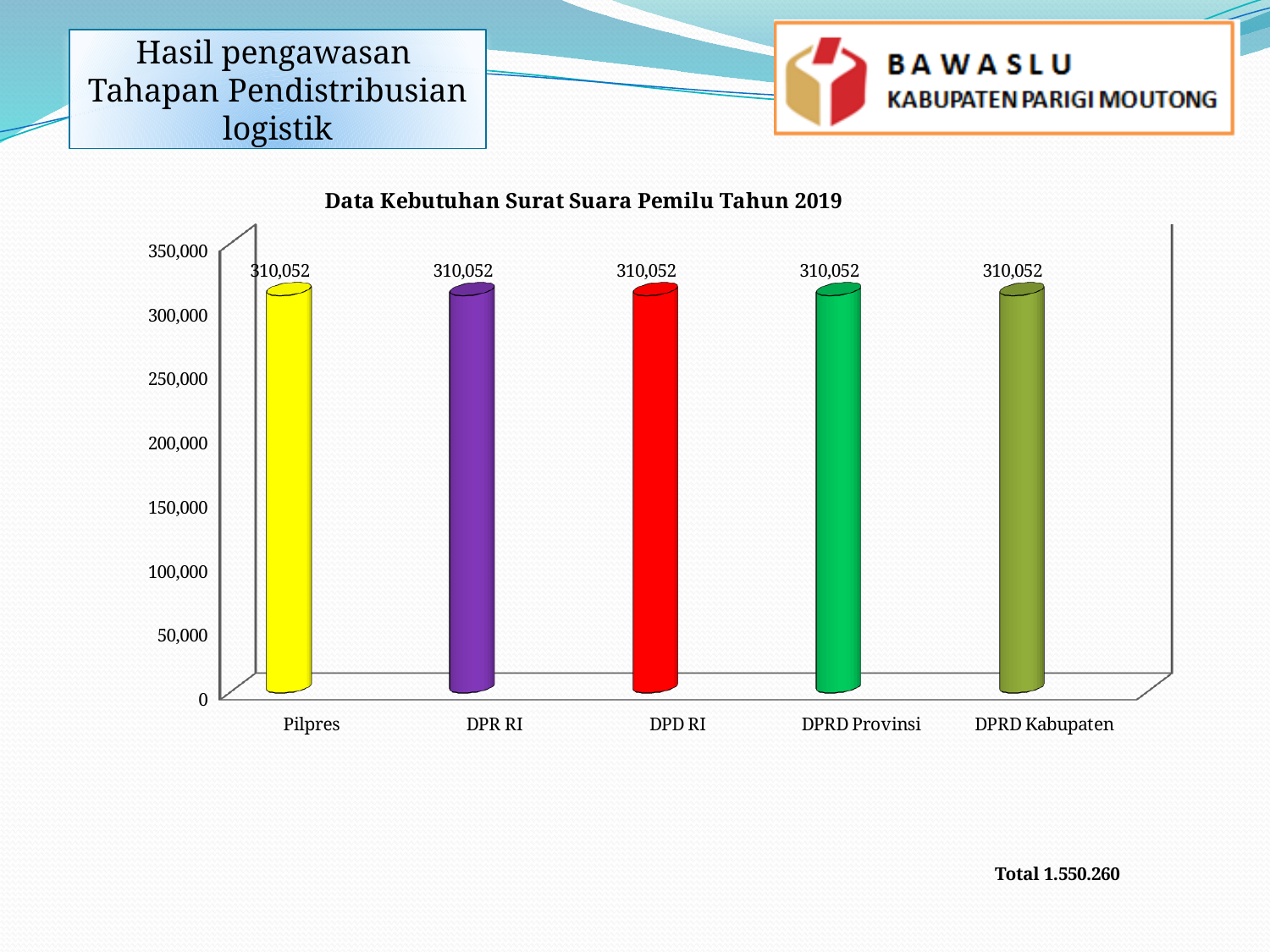
Do the values rise, fall, or stay the same across the categories from Pilpres to DPRD Kabupaten? stay the same What is the value for DPD RI? 310,052 What is the title of the chart? Data Kebutuhan Surat Suara Pemilu Tahun 2019 What is the value for DPRD Kabupaten? 310,052 What is the difference between the values for Pilpres and DPRD Kabupaten? 0 What kind of chart is shown on the slide? bar chart Is the value for DPR RI greater or less than 300,000? greater What is the value for DPRD Provinsi? 310,052 How many categories are shown on the x axis? 5 What is the value for Pilpres? 310,052 What is the value for DPR RI? 310,052 Is the value for DPRD Provinsi greater or less than 350,000? less